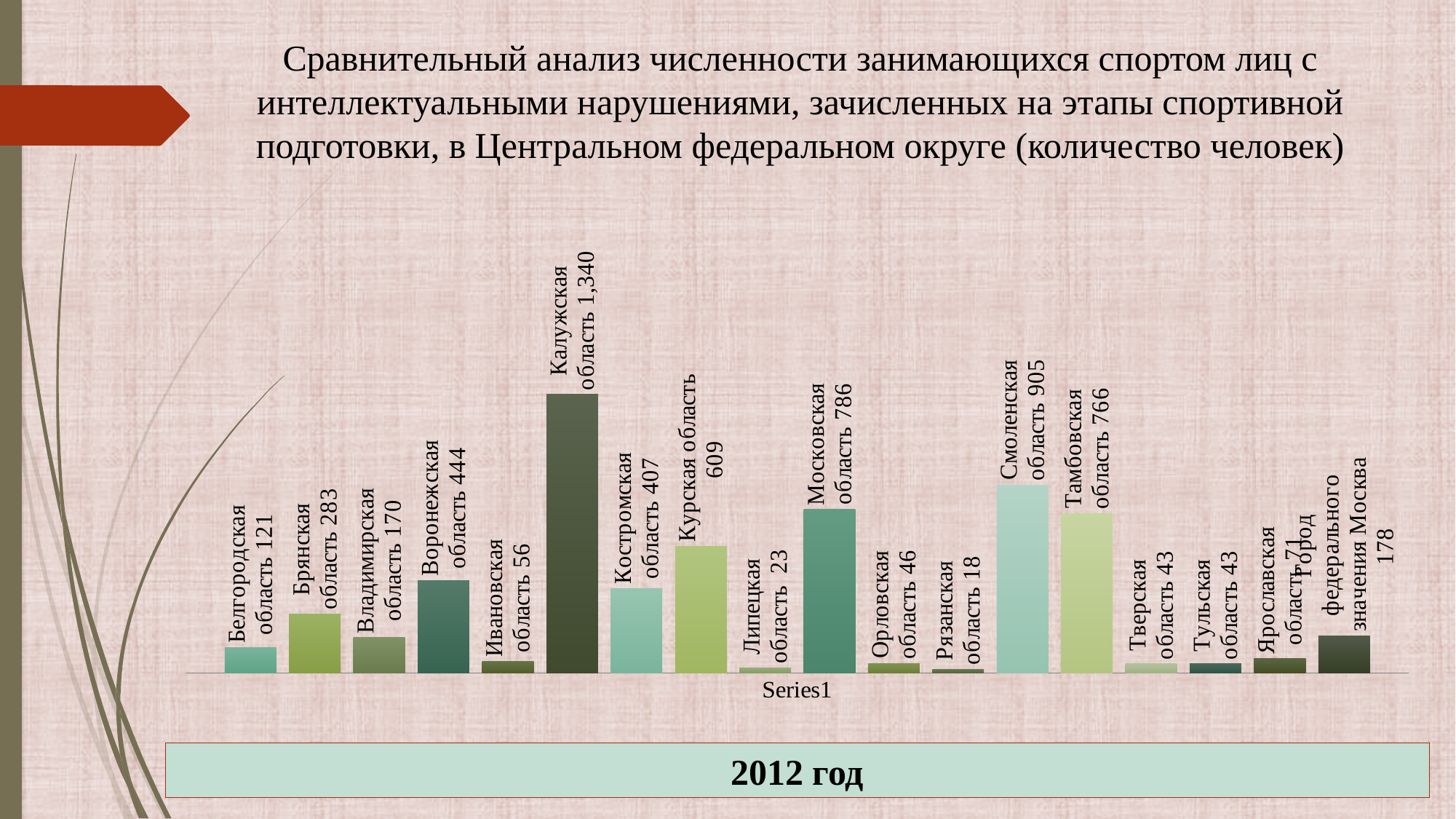
What is the value for Московская область? 786 What is the value for Город федерального значения Москва? 178 How many categories (bars) are shown in the chart? 18 Which category has the lowest value? Рязанская область What is the value for Калужская область? 1,340 What is the difference between the values for Курская область and Костромская область? 202 Which category has the highest value? Калужская область What kind of chart is shown on the slide? Bar chart What is the value for Рязанская область? 18 What year is indicated in the box below the chart? 2012 год What is the difference between the values for Смоленская область and Тамбовская область? 139 Which is larger, the value for Воронежская область or the value for Брянская область? Воронежская область